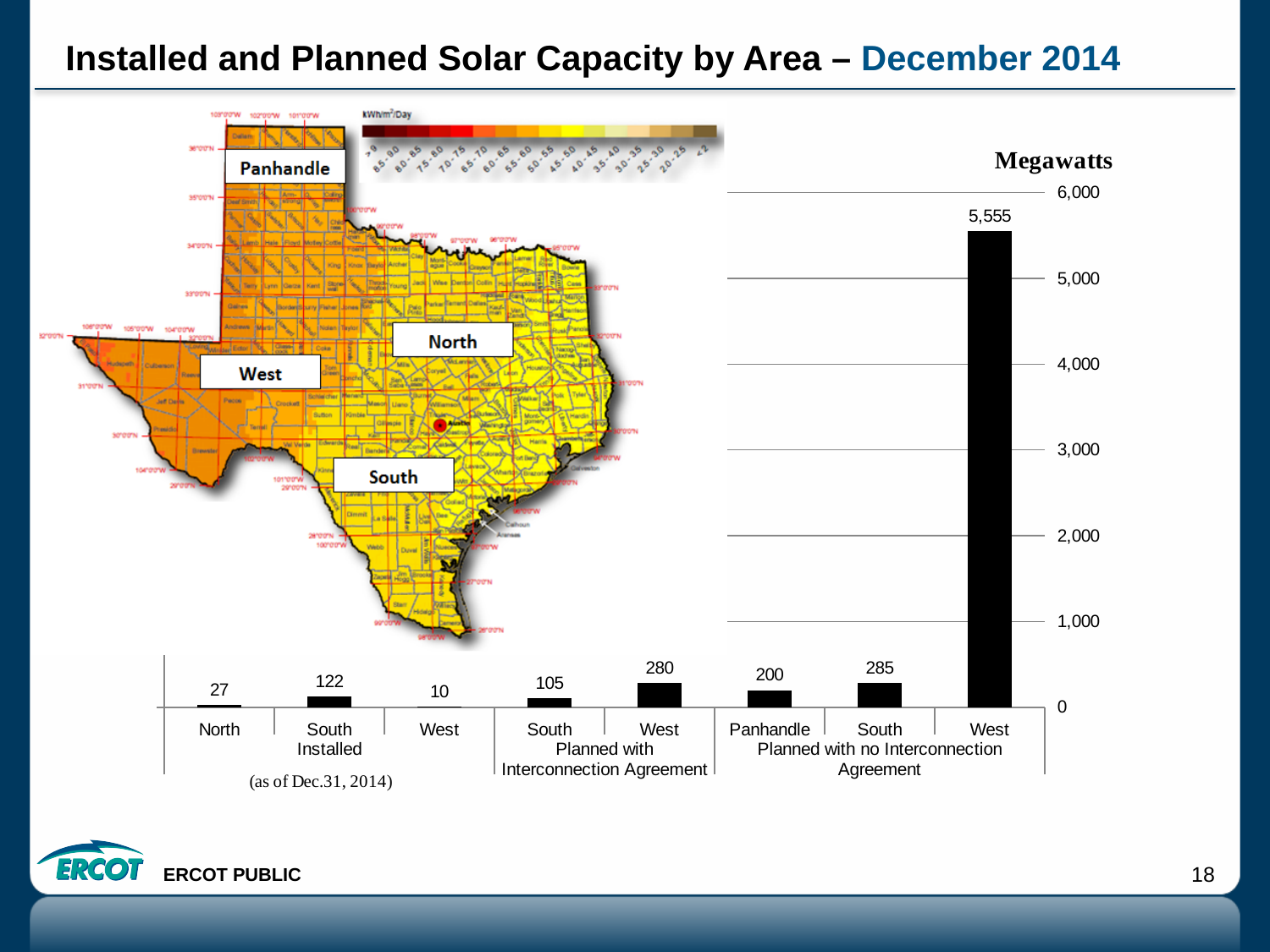
How many bars are plotted in the chart? 8 Which bar in the chart has the lowest value? West, Installed What is the installed solar capacity for North, in megawatts? 27 What is the value for West under 'Planned with no Interconnection Agreement'? 5,555 What unit is shown on the vertical axis of the chart? Megawatts What is the total installed solar capacity across North, South and West? 159 Which bar in the chart has the highest value? West, Planned with no Interconnection Agreement What is the installed solar capacity for South? 122 What is the difference between the installed capacity for South and the installed capacity for North? 95 What is the value for Panhandle under 'Planned with no Interconnection Agreement'? 200 What type of chart is shown on the slide? Bar chart Which is larger: the value for West under 'Planned with Interconnection Agreement' or the value for South under 'Planned with no Interconnection Agreement'? South, Planned with no Interconnection Agreement